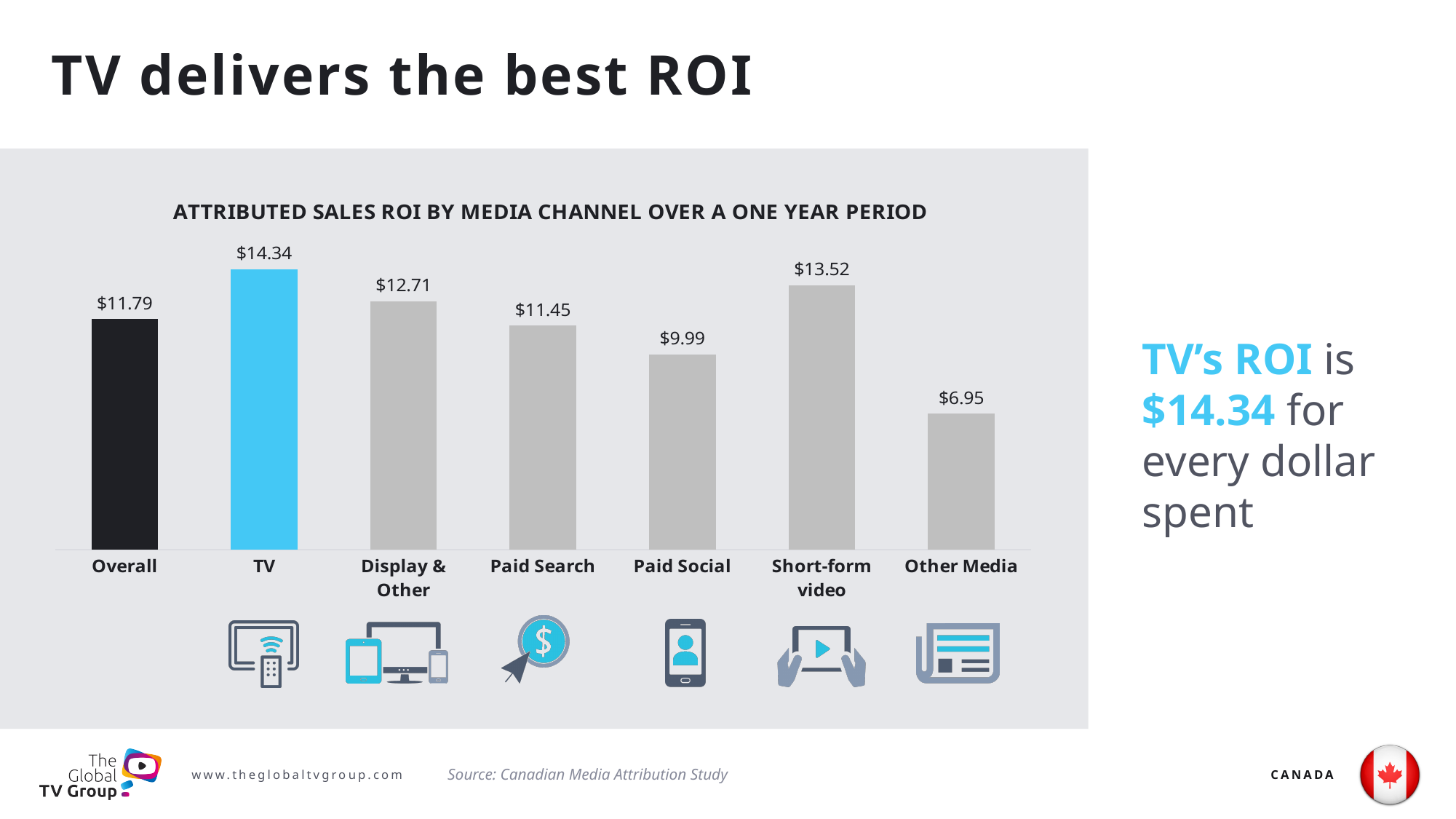
Which media channel has the lowest attributed sales ROI? Other Media What is the attributed sales ROI for Paid Social? $9.99 What is the difference between the ROI for Display & Other and the ROI for Paid Search? $1.26 What is the attributed sales ROI for Short-form video? $13.52 Which media channel has the highest attributed sales ROI? TV What is the attributed sales ROI for TV? $14.34 Which has a higher ROI, Short-form video or Display & Other? Short-form video What is the title of the chart? Attributed Sales ROI by Media Channel Over a One Year Period What kind of chart is shown on the slide? Bar chart What is the difference between the ROI for TV and the ROI for Other Media? $7.39 Which has a higher ROI, Overall or Paid Search? Overall How many categories are shown on the chart? 7